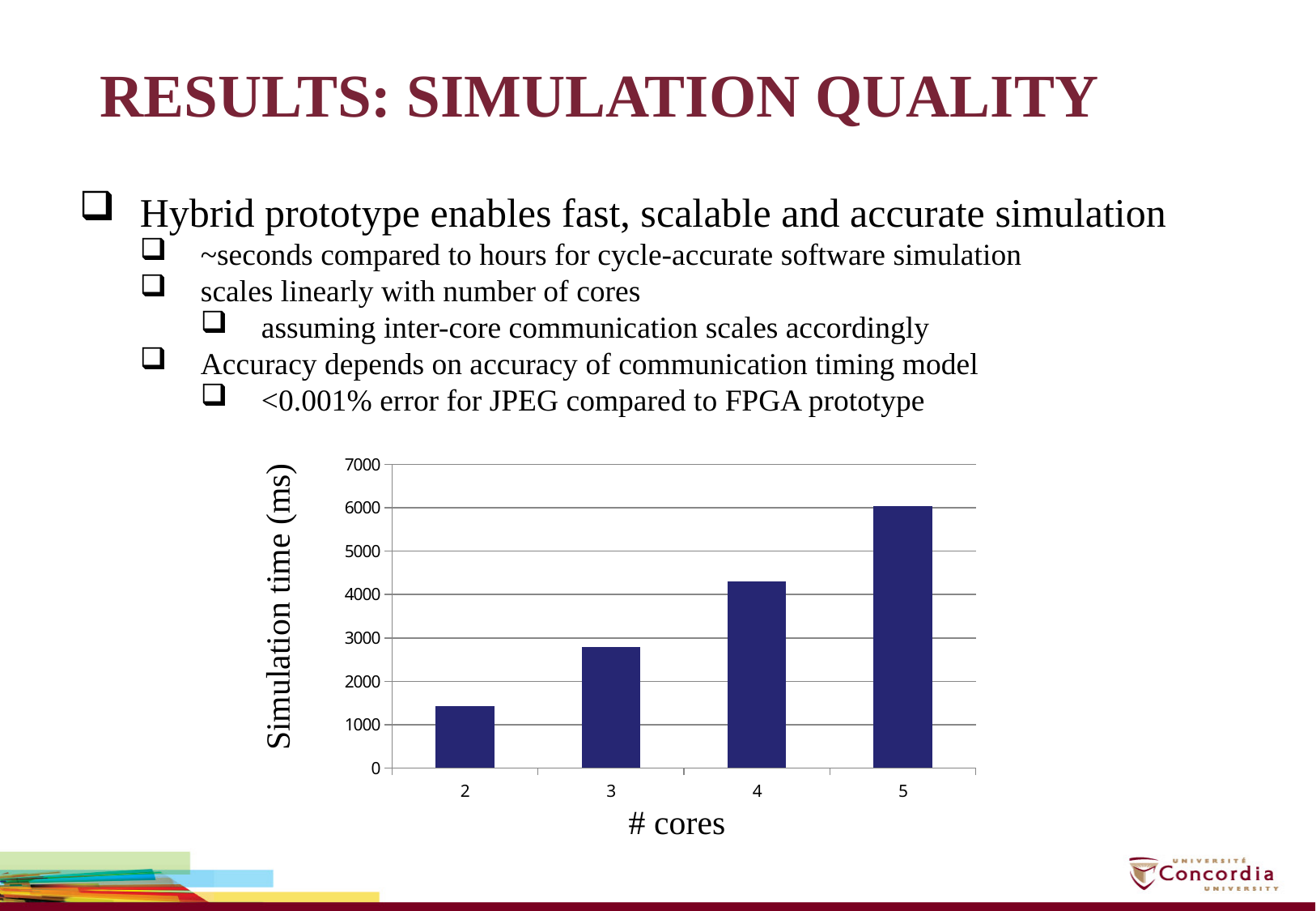
Which number of cores has the highest simulation time? 5 Is the simulation time for 4 cores greater or less than 4000? greater How many bars (core counts) are plotted in the chart? 4 What kind of chart is shown on the slide? bar chart Which number of cores has the lowest simulation time? 2 Is the simulation time for 2 cores greater or less than 2000? less Which has a larger simulation time, 3 cores or 4 cores? 4 cores What is the label of the x axis of the chart? # cores Is the simulation time for 5 cores greater or less than 5000? greater What is the label of the y axis of the chart? Simulation time (ms) Does the simulation time rise or fall as the number of cores increases? rise